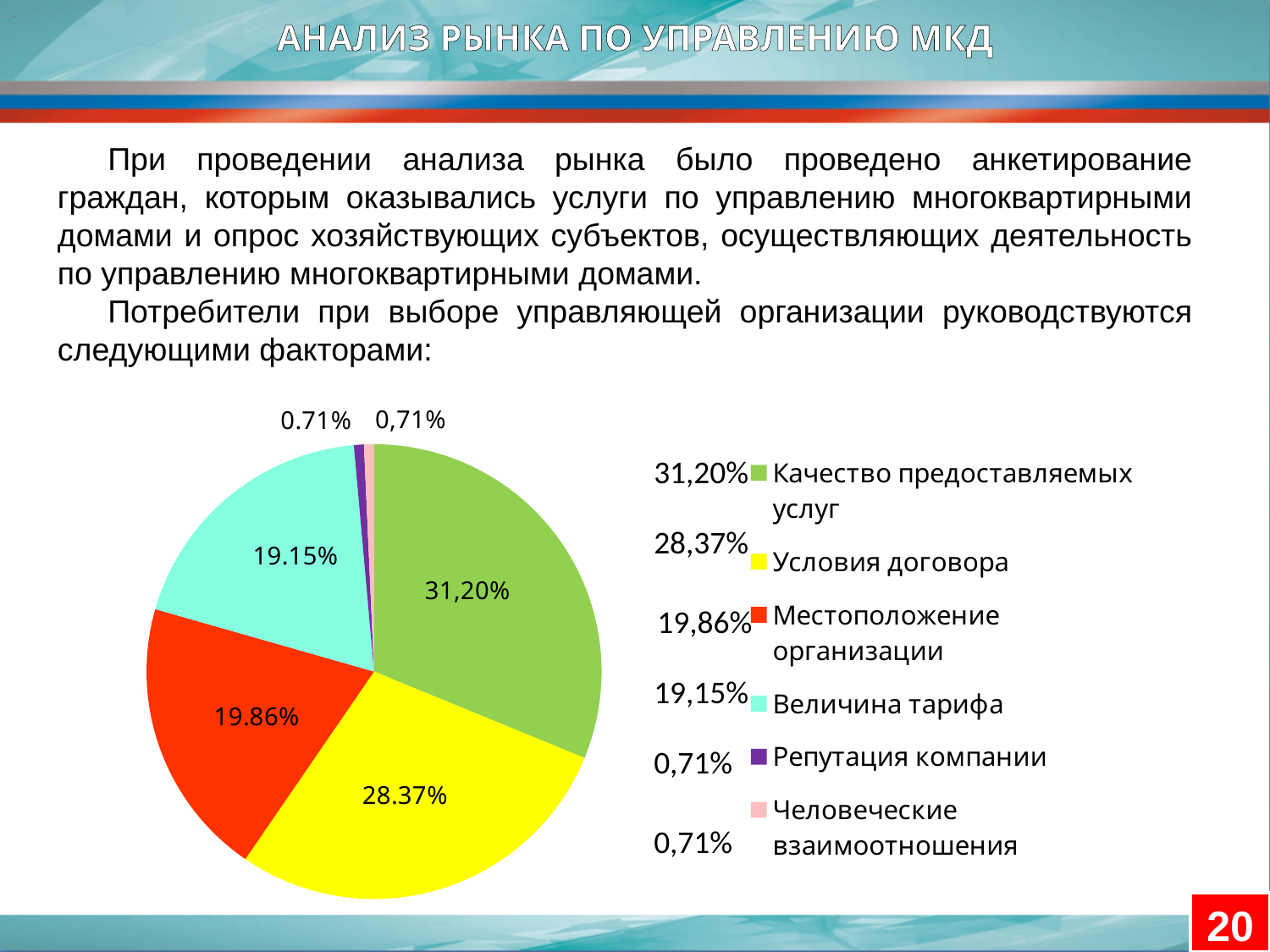
What is the value for "Условия договора"? 28.37% Which category has the largest share of the pie? Качество предоставляемых услуг What share of the pie does "Качество предоставляемых услуг" have? 31,20% What is the value for "Репутация компании"? 0.71% What is the value for "Величина тарифа"? 19.15% How many entries does the legend list? 6 What kind of chart is shown on the slide? pie chart Which is larger, the share for "Условия договора" or the share for "Местоположение организации"? Условия договора What is the value for "Местоположение организации"? 19.86% What colour is the slice for "Условия договора"? yellow How many slices does the pie chart have? 6 What is the difference between the shares for "Качество предоставляемых услуг" and "Условия договора"? 2.83%